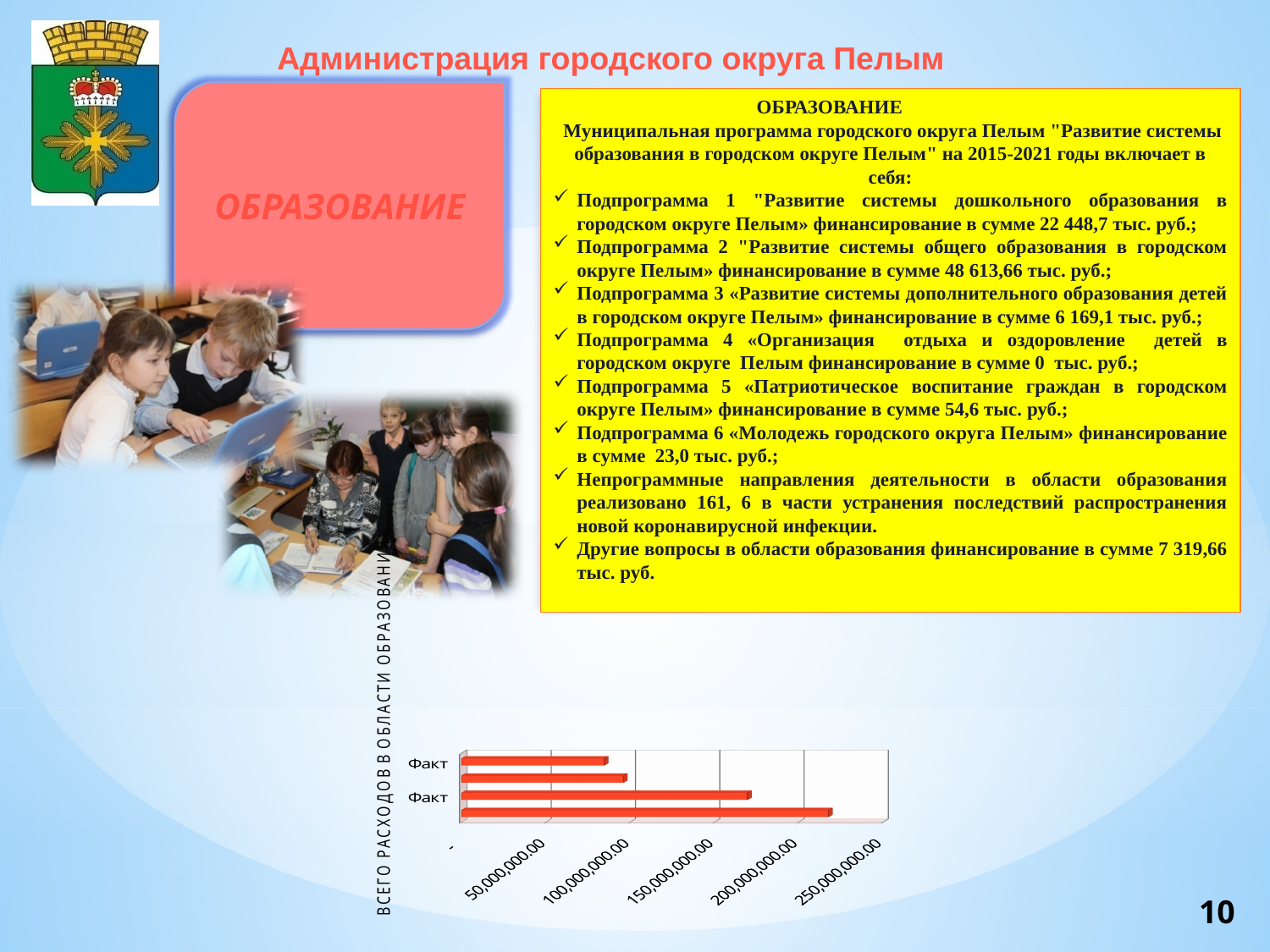
Is the value of the bottommost bar in the chart greater or less than 200,000,000.00? greater Is the value of the topmost bar in the chart greater or less than 100,000,000.00? less Is the value of the second bar from the top in the chart greater or less than 150,000,000.00? less How many bars are plotted in the chart at the bottom of the slide? 4 What is the highest value shown on the horizontal axis of the chart? 250,000,000.00 Which bar in the chart is the longest: the topmost or the bottommost? the bottommost Which bar in the chart has the smallest value? the topmost bar What kind of chart is shown at the bottom of the slide? bar chart What is the title written along the vertical axis of the chart? ВСЕГО РАСХОДОВ В ОБЛАСТИ ОБРАЗОВАНИЯ Which bar in the chart has the largest value? the bottommost bar Do the bar values in the chart increase or decrease going from the top bar to the bottom bar? increase